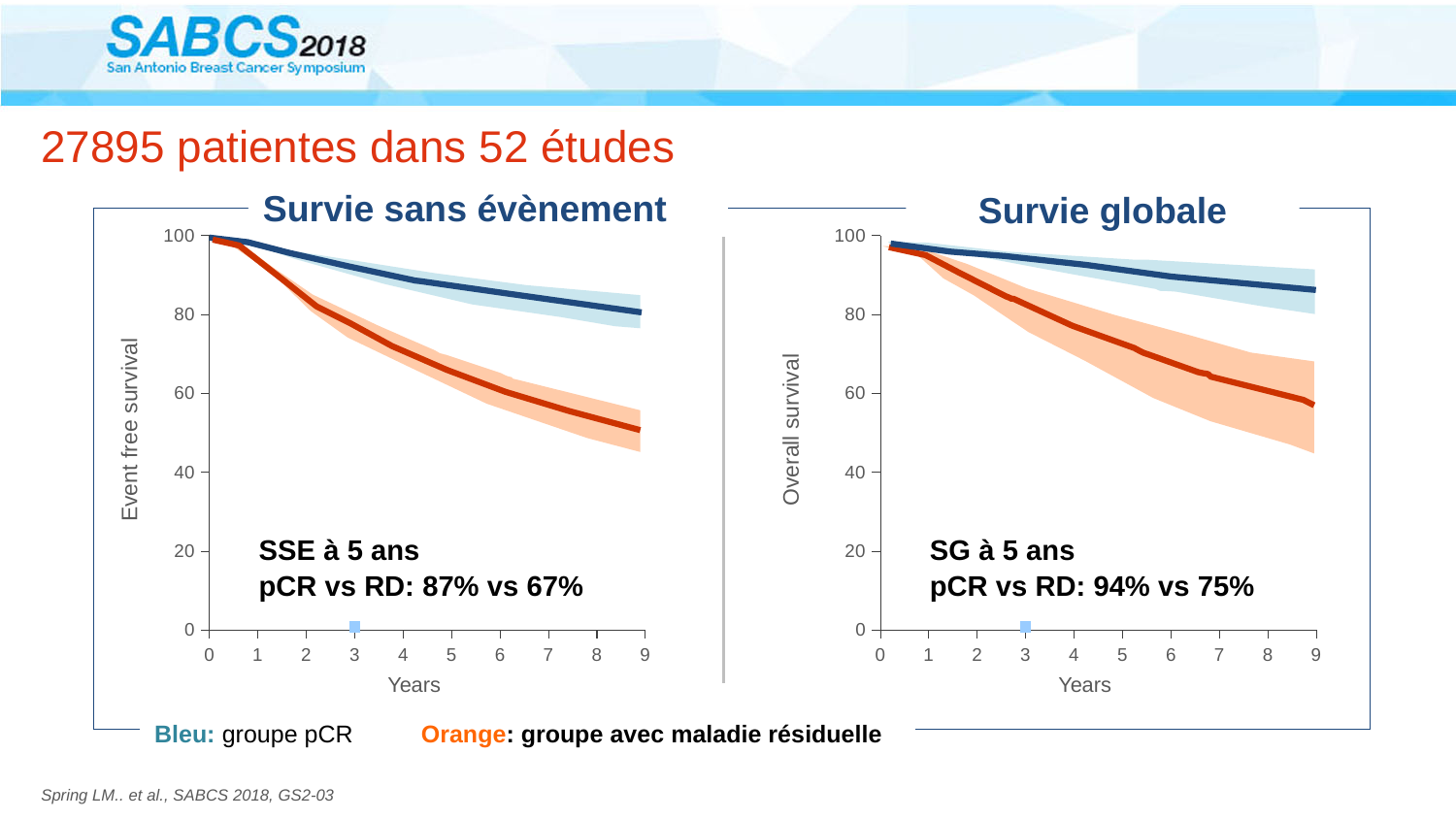
In the 'Survie globale' chart, what is the 5-year overall survival for the pCR group? 94% In the 'Survie sans évènement' chart, is the value of the orange curve at 9 years greater or less than 60? less In the 'Survie globale' chart, what is the difference between the 5-year survival of the pCR group and the RD group? 19% According to the legend, which group does the blue curve represent? groupe pCR What kind of chart is the 'Survie sans évènement' chart? line chart In the 'Survie globale' chart, what is the 5-year overall survival for the RD group? 75% In the 'Survie globale' chart, do the curves rise or fall as the years increase? fall In the 'Survie globale' chart, which group has the higher 5-year overall survival, pCR or RD? pCR In the 'Survie sans évènement' chart, what is the 5-year event-free survival for the pCR group? 87% In the 'Survie sans évènement' chart, what is the 5-year event-free survival for the RD group? 67% In the 'Survie globale' chart, is the value of the blue curve at 9 years greater or less than 80? greater In the 'Survie sans évènement' chart, what is the difference between the 5-year survival of the pCR group and the RD group? 20%